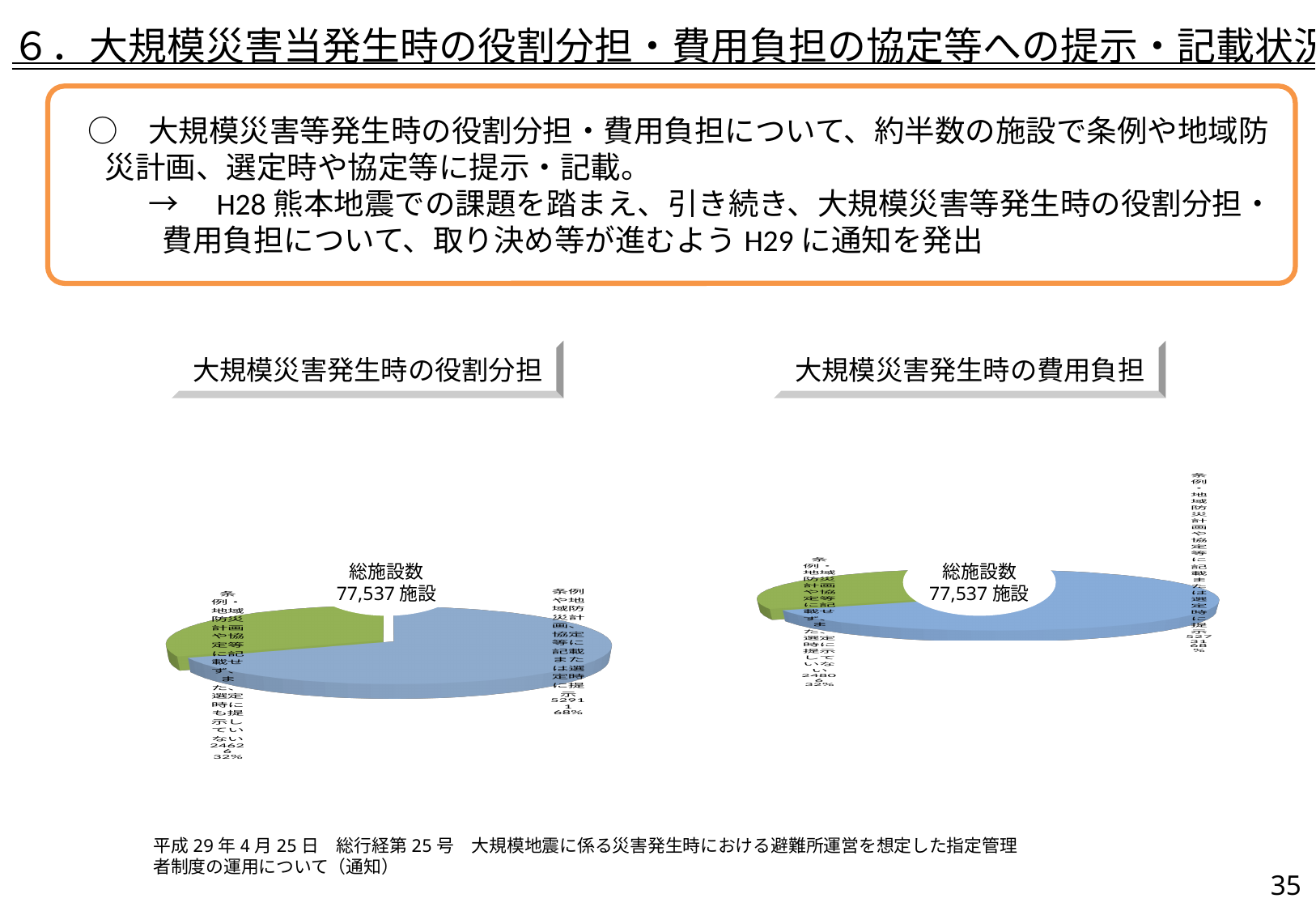
In the 大規模災害発生時の役割分担 chart, which slice is larger: 記載または選定時に提示 or 記載せず、また、選定時にも提示していない? 記載または選定時に提示 What kind of chart is the 大規模災害発生時の役割分担 chart on the left? pie chart In the 大規模災害発生時の役割分担 chart, what is the 総施設数 shown in the centre? 77,537 施設 How many slices does the 大規模災害発生時の費用負担 pie chart have? 2 In the 大規模災害発生時の役割分担 chart, how many facilities are 条例や地域防災計画、協定等に記載または選定時に提示? 52911 In the 大規模災害発生時の費用負担 chart, what is the 総施設数 shown in the centre? 77,537 施設 How many slices does the 大規模災害発生時の役割分担 pie chart have? 2 In the 大規模災害発生時の役割分担 chart, what share of facilities are 条例・地域防災計画や協定等に記載せず、また、選定時にも提示していない? 32% In the 大規模災害発生時の役割分担 chart, what colour is the larger slice? blue In the 大規模災害発生時の役割分担 chart, how many facilities are 条例・地域防災計画や協定等に記載せず、また、選定時にも提示していない? 24626 In the 大規模災害発生時の役割分担 chart, what share of facilities are 条例や地域防災計画、協定等に記載または選定時に提示? 68% What kind of chart is the 大規模災害発生時の費用負担 chart on the right? pie chart